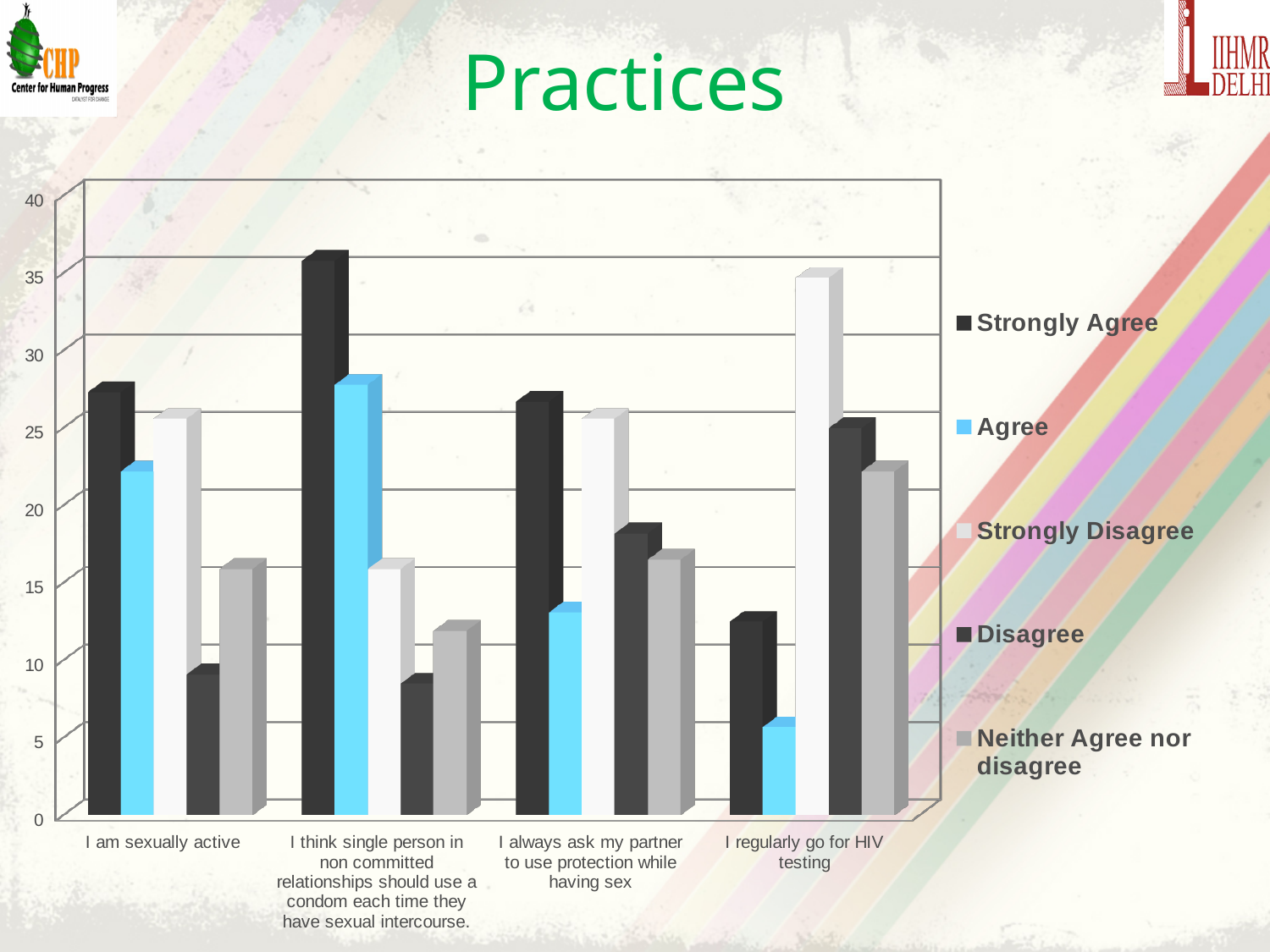
For "I regularly go for HIV testing", which is larger: Strongly Agree or Strongly Disagree? Strongly Disagree For "I always ask my partner to use protection while having sex", which is larger: Agree or Disagree? Disagree Which category has the lowest Agree value? I regularly go for HIV testing What kind of chart is shown on the slide? Bar chart Which category has the highest Strongly Disagree value? I regularly go for HIV testing Is the Strongly Disagree value for "I regularly go for HIV testing" greater or less than 30? greater How many categories are shown along the x axis of the chart? 4 Is the Agree value for "I regularly go for HIV testing" greater or less than 10? less What is the title of the slide containing the chart? Practices How many series does the chart's legend list? 5 Which category has the highest Strongly Agree value? I think single person in non committed relationships should use a condom each time they have sexual intercourse. Is the Strongly Agree value for "I am sexually active" greater or less than 25? greater